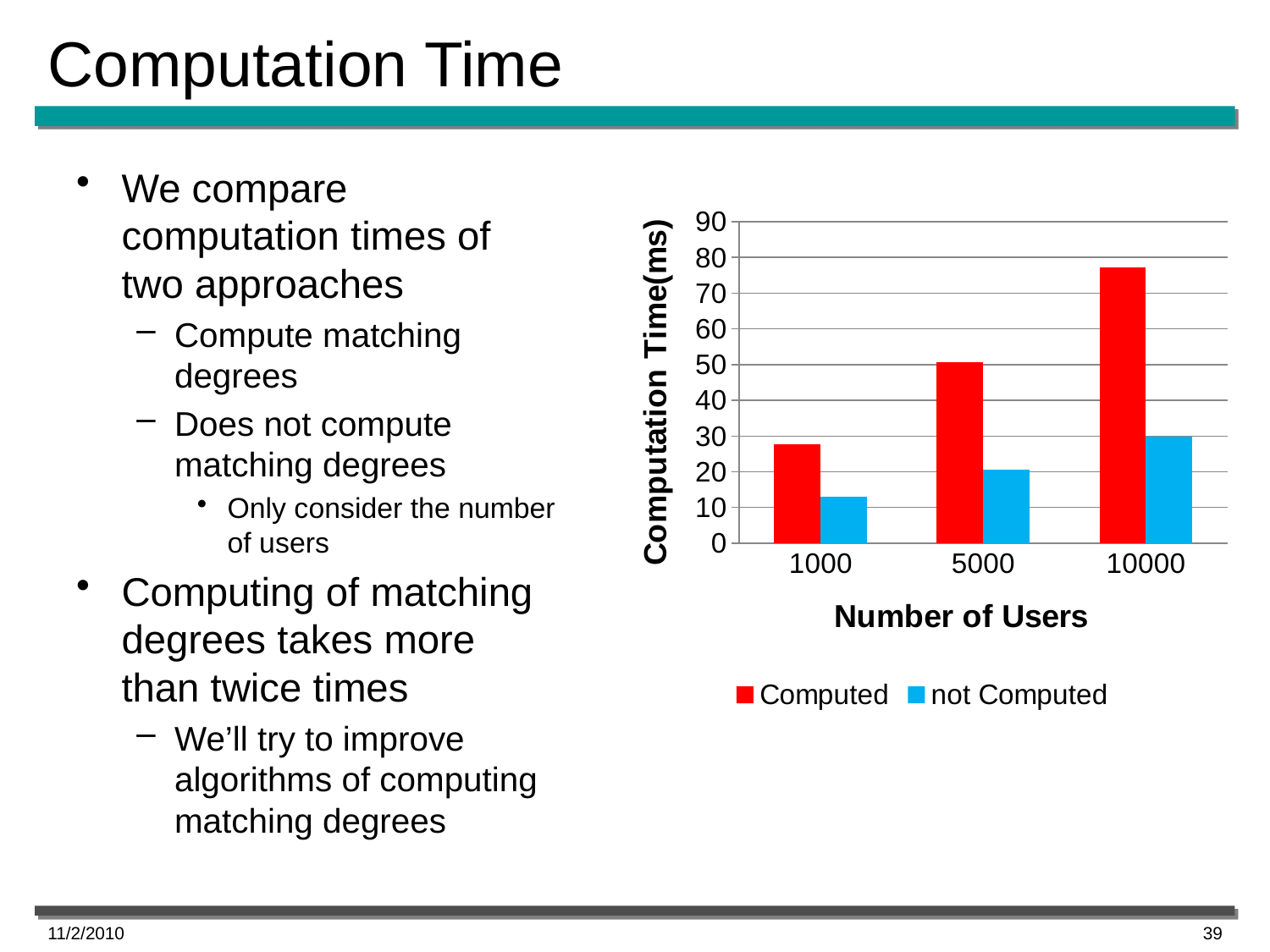
For 5000 users, which series has the larger value, Computed or not Computed? Computed Is the Computed value for 10000 users greater or less than 70? greater How many categories are shown on the x axis? 3 How many series does the legend list? 2 Which number of users has the highest Computed computation time? 10000 What is the label of the y axis? Computation Time(ms) Do the Computed values rise or fall as the number of users increases? rise Is the not Computed value for 10000 users greater or less than 40? less What kind of chart is shown on the slide? bar chart Is the not Computed value for 1000 users greater or less than 20? less Which number of users has the lowest not Computed computation time? 1000